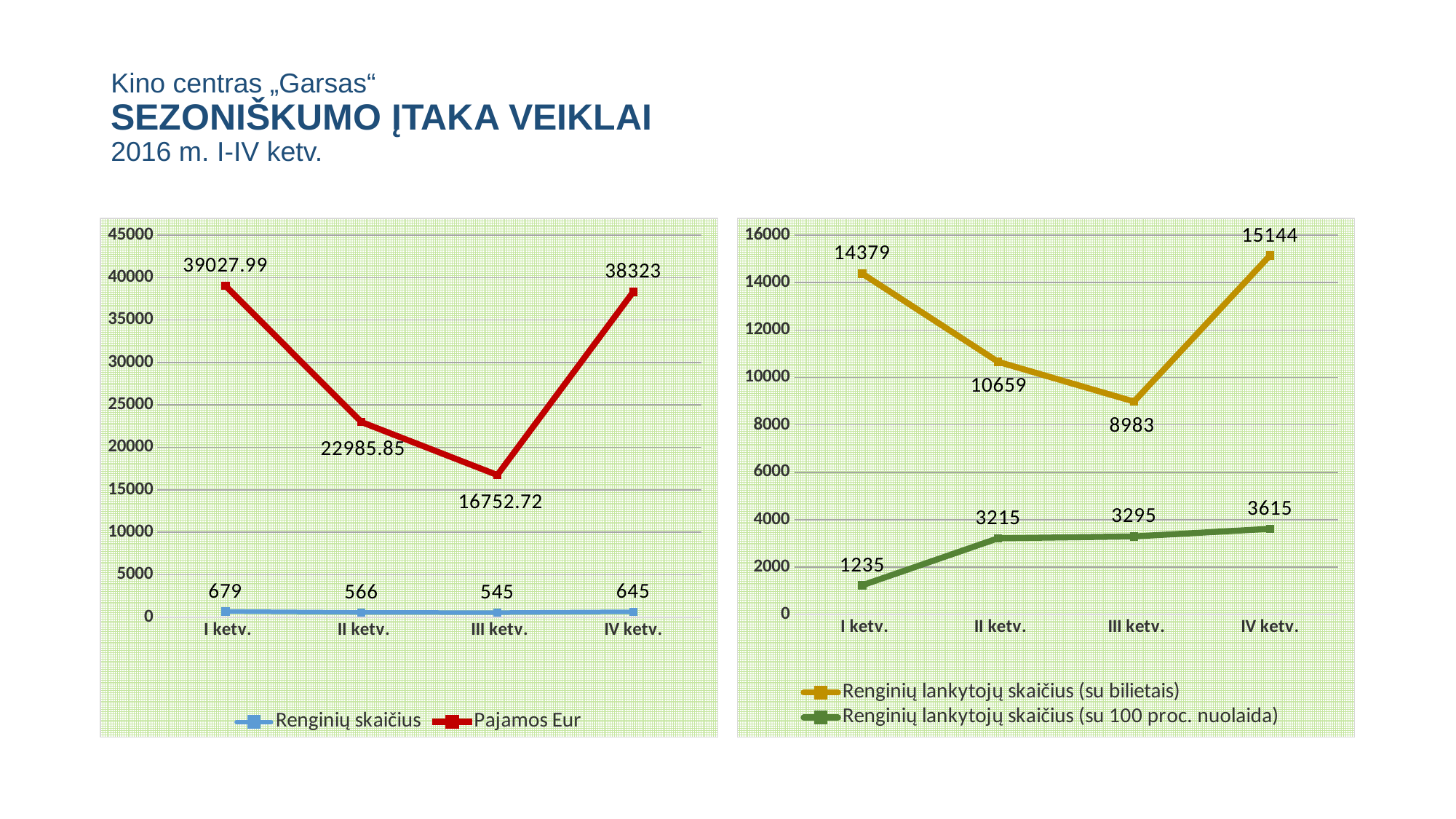
In the right chart, which quarter has the highest Renginių lankytojų skaičius (su bilietais)? IV ketv. What kind of chart is the right chart? line chart In the left chart, what is the value of Renginių skaičius for III ketv.? 545 In the right chart, what is the difference between Renginių lankytojų skaičius (su 100 proc. nuolaida) for IV ketv. and I ketv.? 2380 In the left chart, which quarter has the highest Renginių skaičius? I ketv. In the left chart, which quarter has the lowest Pajamos Eur? III ketv. In the left chart, what is the value of Pajamos Eur for I ketv.? 39027.99 In the left chart, how many series does the legend list? 2 In the right chart, what is the value of Renginių lankytojų skaičius (su 100 proc. nuolaida) for II ketv.? 3215 In the right chart, does Renginių lankytojų skaičius (su 100 proc. nuolaida) rise or fall from I ketv. to IV ketv.? rise In the right chart, what is the value of Renginių lankytojų skaičius (su bilietais) for III ketv.? 8983 In the left chart, what is the difference between Pajamos Eur for I ketv. and IV ketv.? 704.99